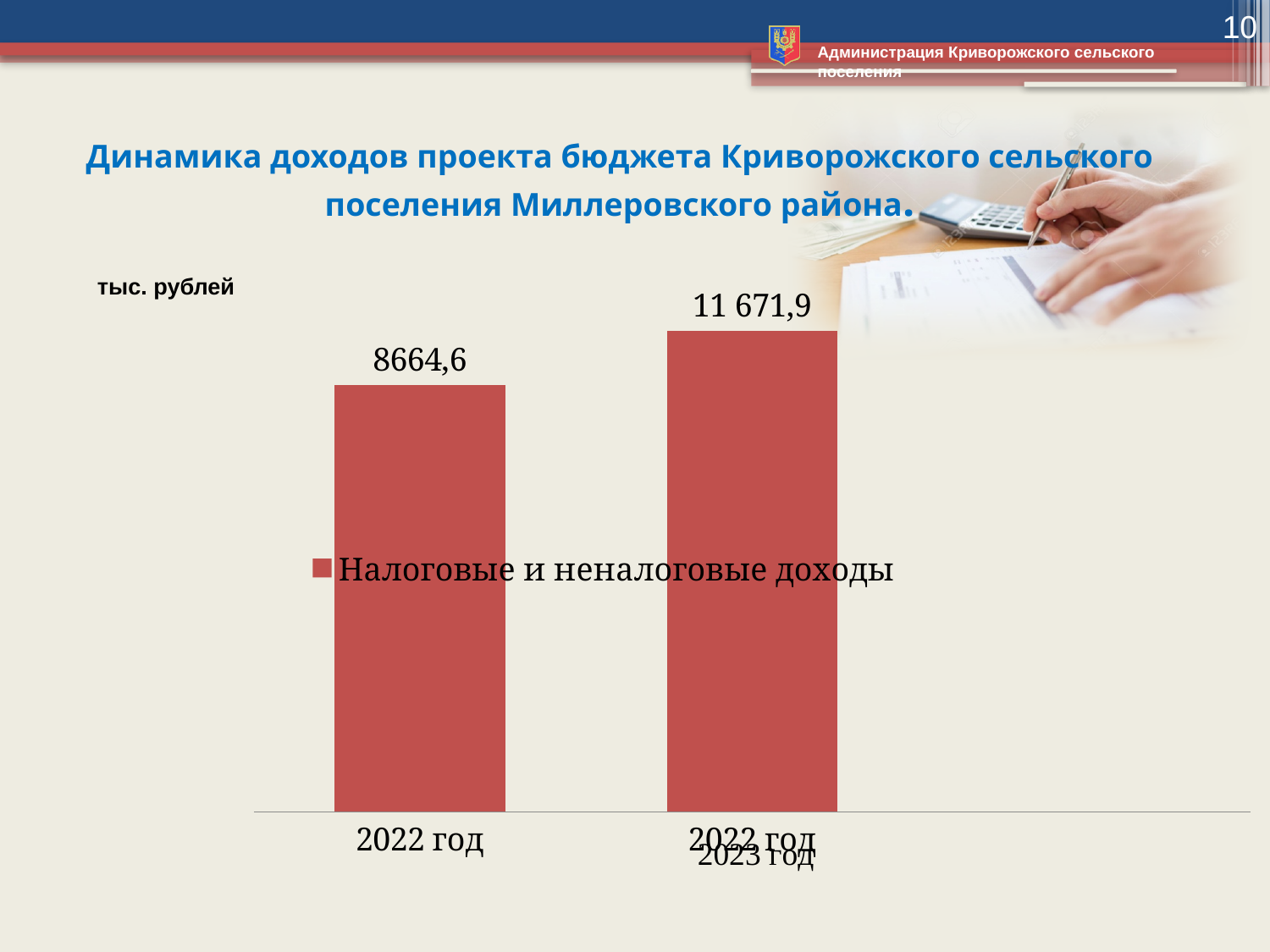
In what units are the chart values given, according to the label above the chart? тыс. рублей How many series does the legend list? 1 How many bars (categories) are plotted in the chart? 2 Which year has the lower value of tax and non-tax revenues? 2022 год Which year has the higher value of tax and non-tax revenues? 2023 год What is the value of tax and non-tax revenues (Налоговые и неналоговые доходы) for 2022 год? 8664,6 What series name is shown in the chart legend? Налоговые и неналоговые доходы Is the value for 2023 год larger or smaller than the value for 2022 год? larger By how much does the 2023 год value exceed the 2022 год value? 3007,3 What is the value of tax and non-tax revenues (Налоговые и неналоговые доходы) for 2023 год? 11 671,9 What type of chart is shown on the slide? bar chart Do the values rise or fall from 2022 год to 2023 год? rise